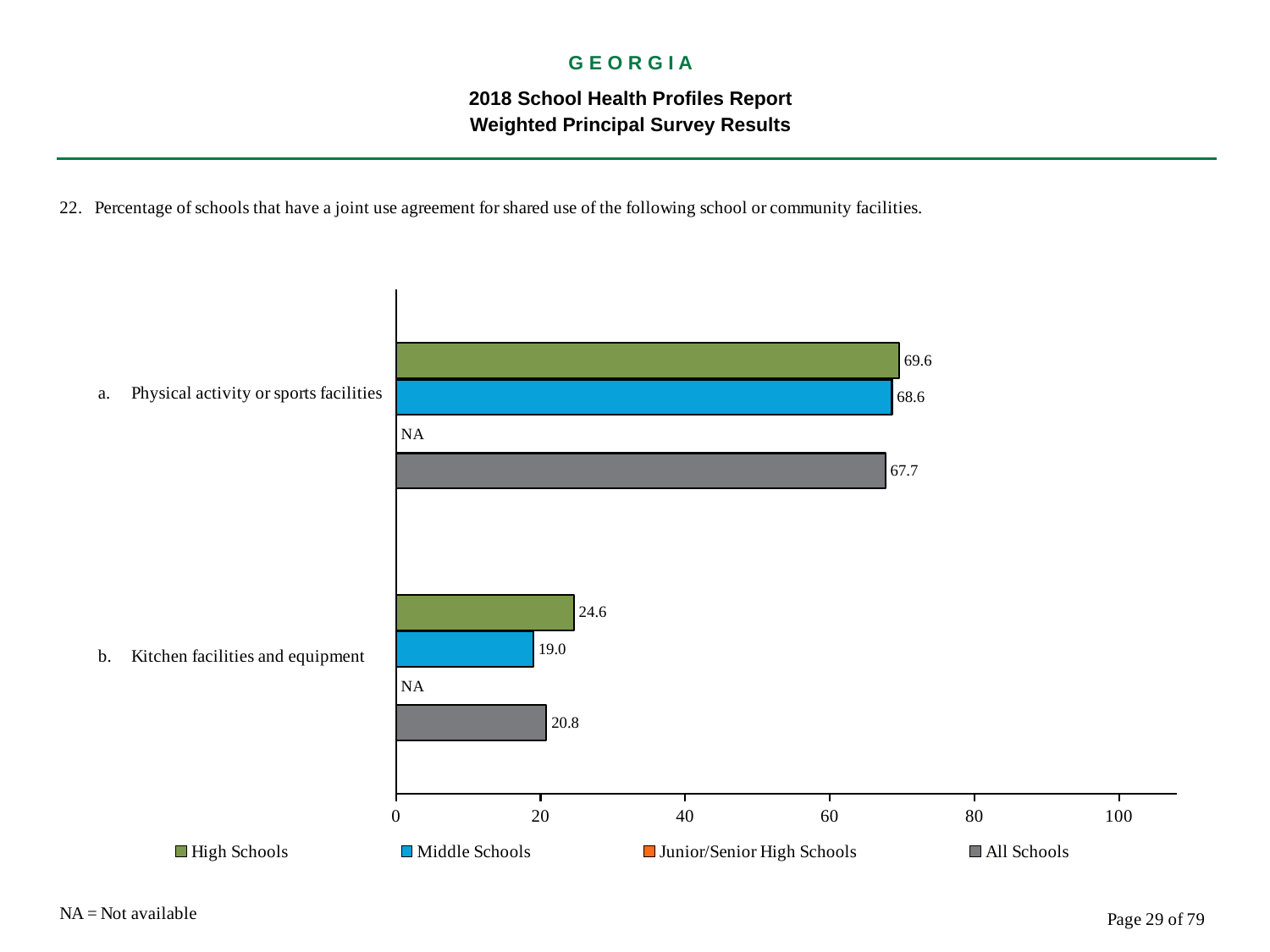
What is the value for All Schools for Physical activity or sports facilities? 67.7 How many series does the legend list? 4 Which is larger for Physical activity or sports facilities: High Schools or All Schools? High Schools What is shown for Junior/Senior High Schools for Kitchen facilities and equipment? NA What is the value for Middle Schools for Kitchen facilities and equipment? 19.0 Which series has the highest value for Kitchen facilities and equipment? High Schools What is the difference between the High Schools and Middle Schools values for Kitchen facilities and equipment? 5.6 What kind of chart is shown on the slide? Bar chart What does NA stand for on this slide? Not available What is the value for All Schools for Kitchen facilities and equipment? 20.8 What is the value for High Schools for Physical activity or sports facilities? 69.6 Which series has the lowest value for Kitchen facilities and equipment? Middle Schools